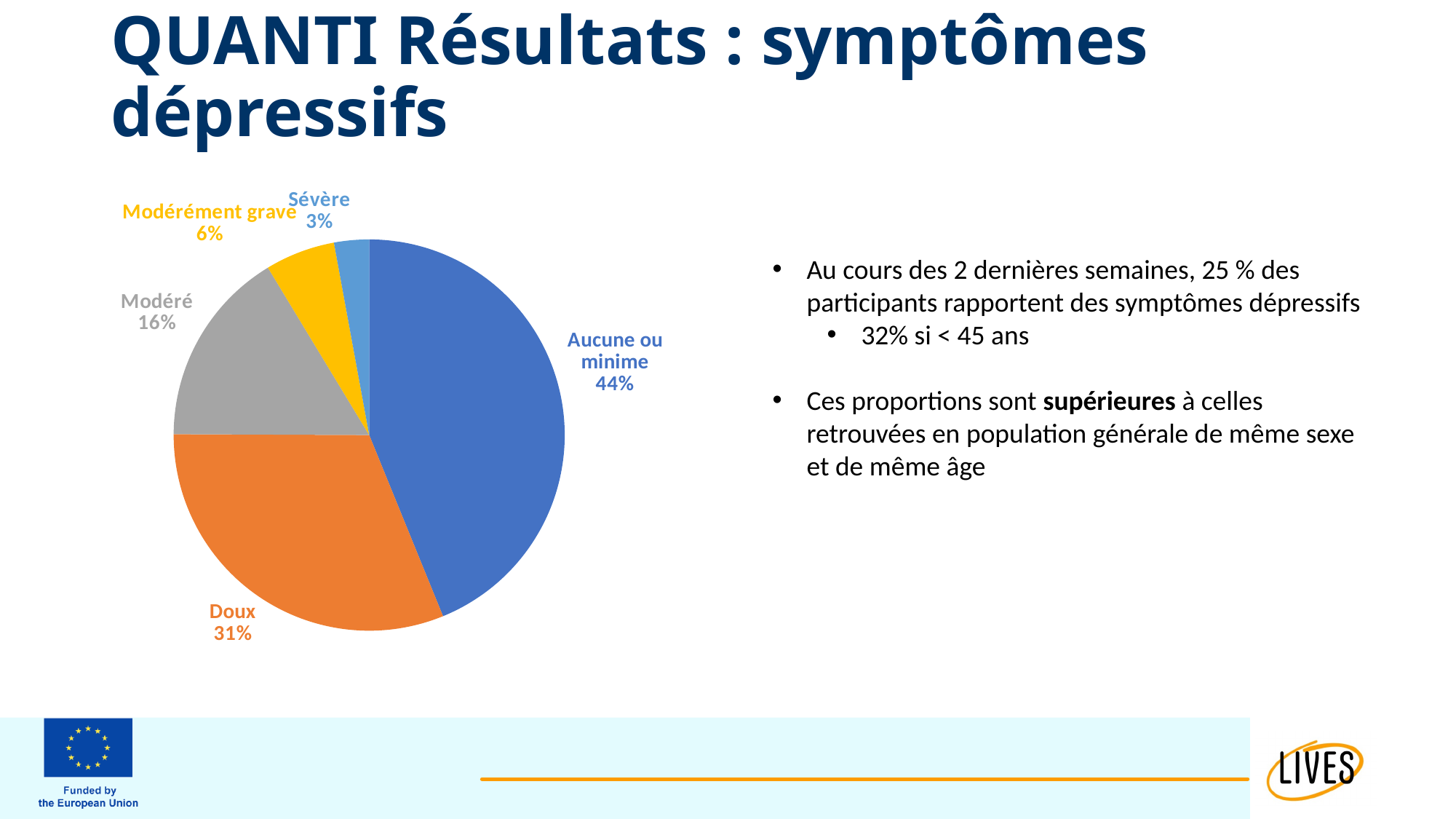
What is the value shown for the "Modéré" slice? 16% Which category has the largest slice of the pie? Aucune ou minime What is the value shown for the "Doux" slice? 31% What is the difference between the "Aucune ou minime" and "Doux" slices? 13% What share of the pie does the "Aucune ou minime" slice represent? 44% What colour is the "Doux" slice? orange What is the value shown for the "Modérément grave" slice? 6% What is the value shown for the "Sévère" slice? 3% What kind of chart is shown on the slide? pie chart How many slices does the pie chart have? 5 Which category has the smallest slice of the pie? Sévère Which is larger, the "Modéré" slice or the "Modérément grave" slice? Modéré